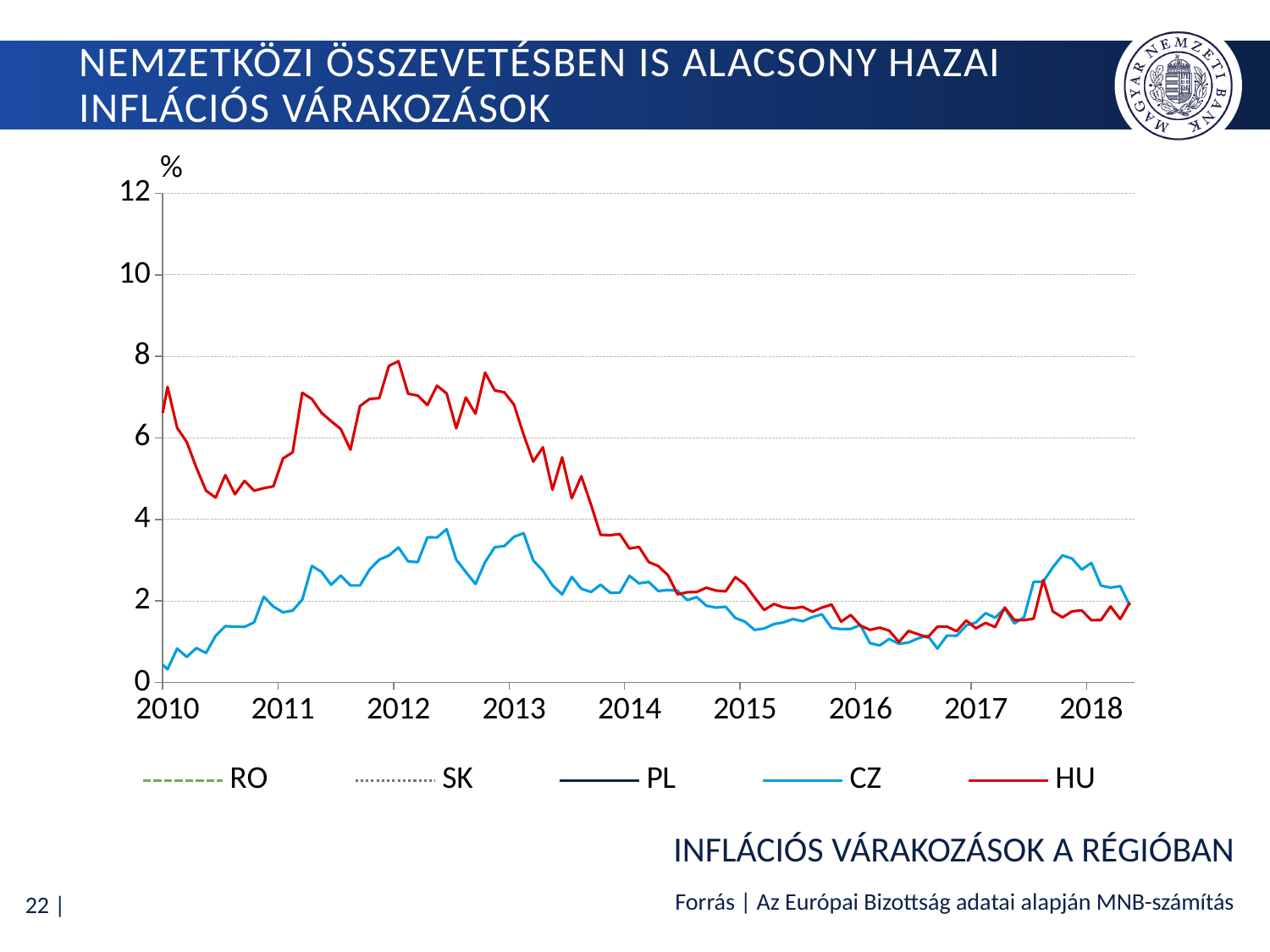
How many series does the legend list? 5 What unit is shown on the vertical axis of the chart? % Is the value for HU at the start of 2016 greater or less than 2? less What kind of chart is shown on the slide? line chart Is the value for CZ at the start of 2010 greater or less than 2? less Which series has the higher value at the start of 2018, HU or CZ? CZ Does the HU series rise or fall between 2013 and 2016? fall Does the CZ series rise or fall between 2010 and 2012? rise What is the title of the chart? INFLÁCIÓS VÁRAKOZÁSOK A RÉGIÓBAN Is the value for HU at the start of 2010 greater or less than 6? greater Which series has the higher value at the start of 2012, HU or CZ? HU